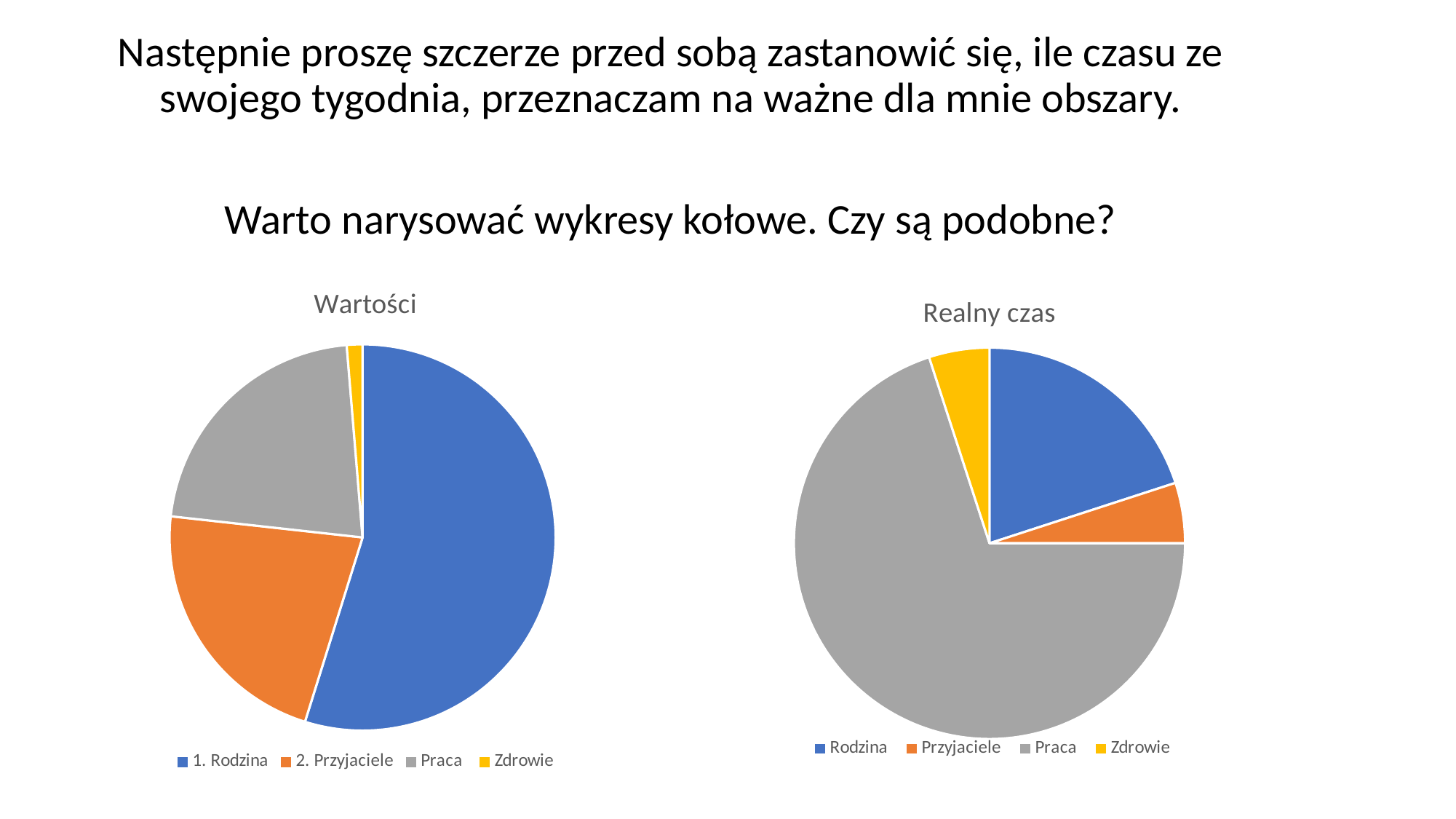
In the "Realny czas" chart, which slice is larger: Praca or Rodzina? Praca What kind of chart is the "Realny czas" chart? pie chart How many categories does the legend of the "Realny czas" chart list? 4 In the "Realny czas" chart, which slice is larger: Rodzina or Przyjaciele? Rodzina What is the title of the pie chart on the right side of the slide? Realny czas In the "Wartości" chart, which colour represents Zdrowie? yellow In the "Wartości" chart, which category has the largest slice? 1. Rodzina In the "Realny czas" chart, which category has the largest slice? Praca How many slices does the "Wartości" pie chart have? 4 What kind of chart is the "Wartości" chart? pie chart In the "Wartości" chart, which slice is larger: 1. Rodzina or Praca? 1. Rodzina In the "Wartości" chart, which category has the smallest slice? Zdrowie